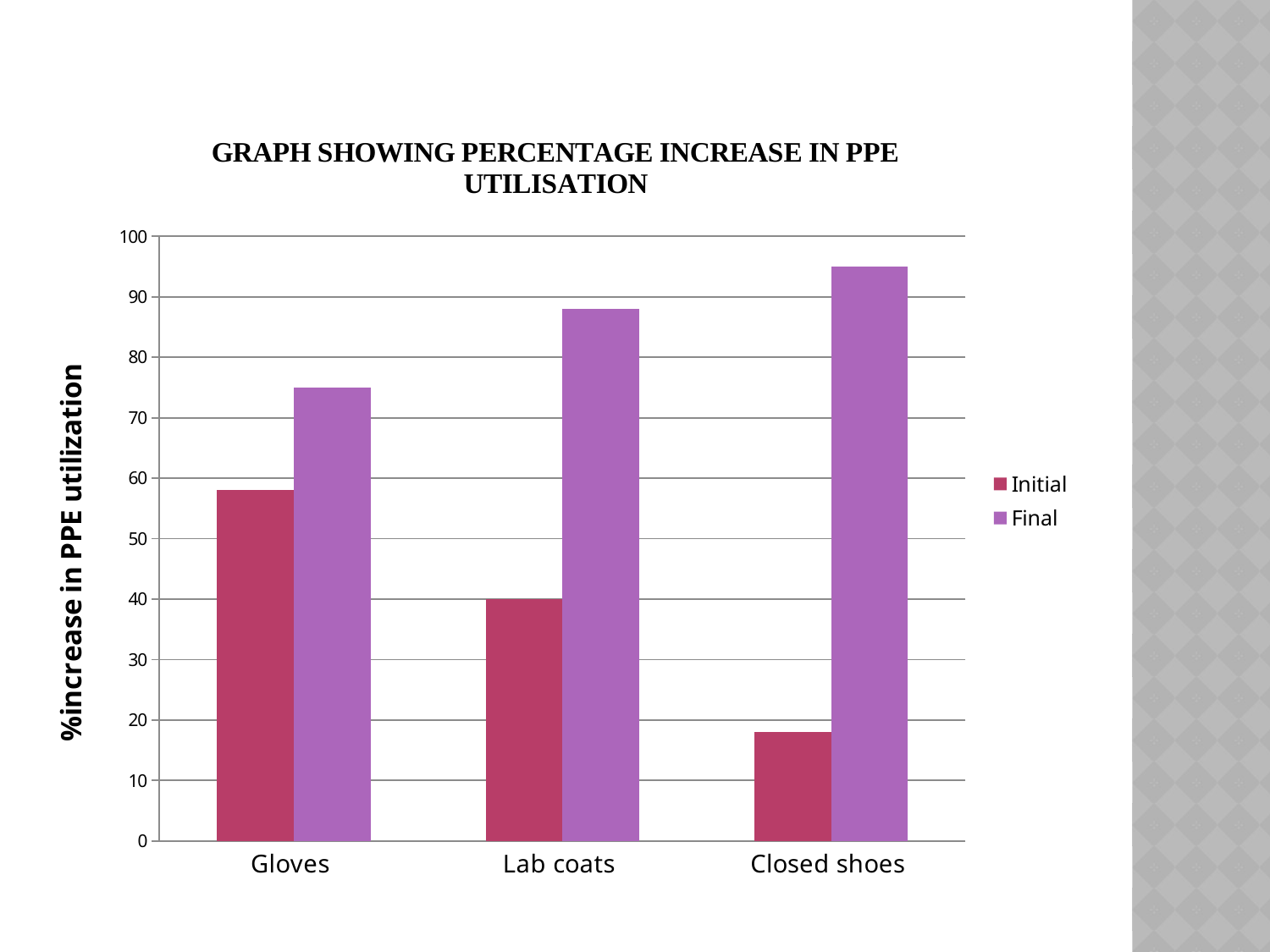
What is the label on the vertical axis of the chart? %increase in PPE utilization What kind of chart is shown on the slide? bar chart Which category has the highest Initial value? Gloves Which category has the lowest Initial value? Closed shoes For Gloves, which is larger: the Initial value or the Final value? Final How many categories are shown on the x axis of the chart? 3 Is the Final value for Closed shoes greater or less than 90? greater Is the Initial value for Gloves greater or less than 50? greater Which category has the highest Final value? Closed shoes Do the Final values rise or fall moving from Gloves to Closed shoes along the x axis? rise How many series does the legend list? 2 Is the Initial value for Closed shoes greater or less than 20? less